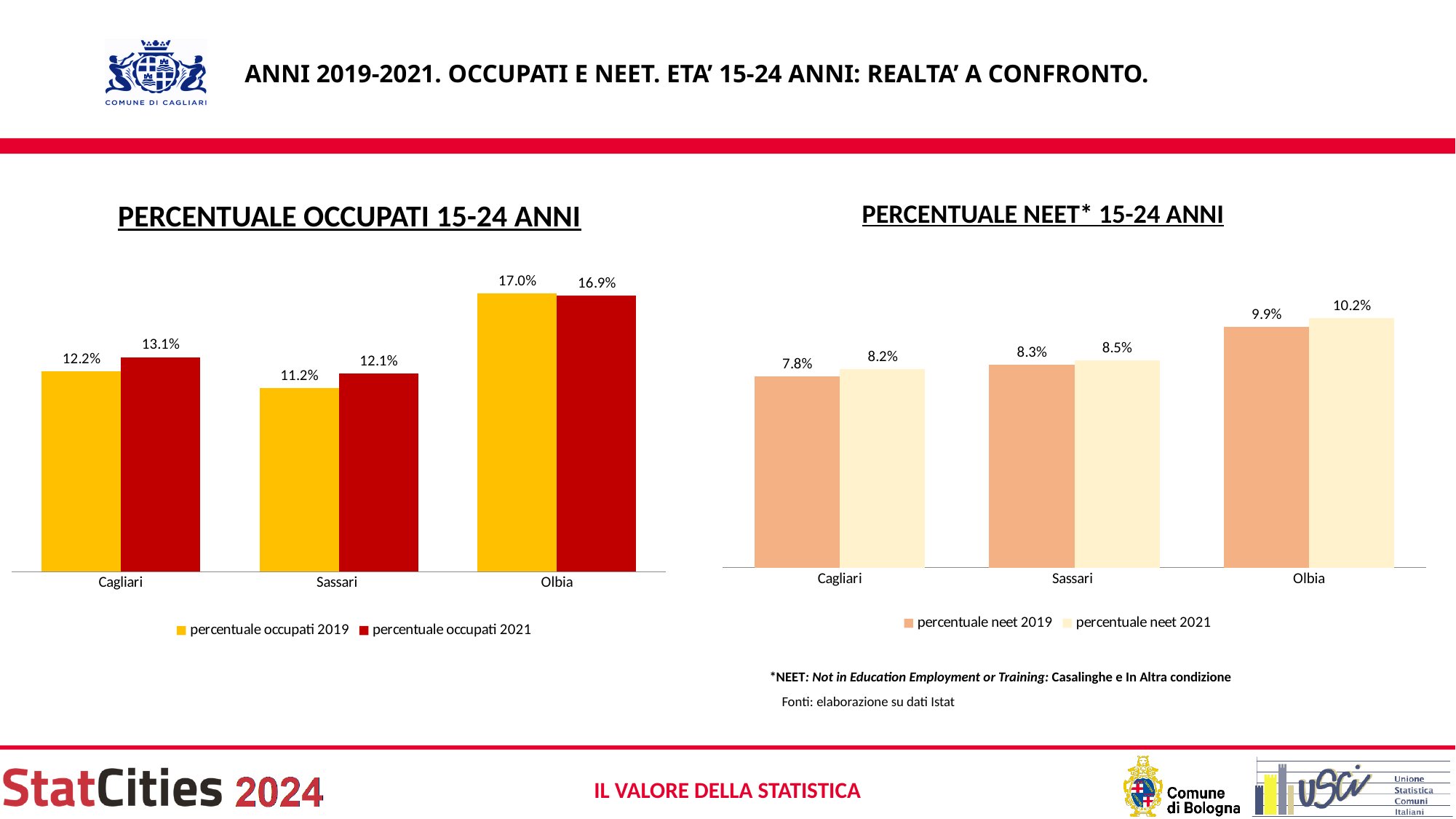
In the 'PERCENTUALE OCCUPATI 15-24 ANNI' chart, how many series does the legend list? 2 In the 'PERCENTUALE NEET* 15-24 ANNI' chart, which city has the lowest value for 'percentuale neet 2019'? Cagliari In the 'PERCENTUALE NEET* 15-24 ANNI' chart, what is the difference between the 2021 and 2019 values for Sassari? 0.2% In the 'PERCENTUALE OCCUPATI 15-24 ANNI' chart, what is the value for Cagliari in the 'percentuale occupati 2019' series? 12.2% In the 'PERCENTUALE OCCUPATI 15-24 ANNI' chart, what is the value for Sassari in the 'percentuale occupati 2021' series? 12.1% In the 'PERCENTUALE OCCUPATI 15-24 ANNI' chart, what is the difference between the 2021 and 2019 values for Cagliari? 0.9% In the 'PERCENTUALE OCCUPATI 15-24 ANNI' chart, which city has the lowest value for 'percentuale occupati 2021'? Sassari In the 'PERCENTUALE NEET* 15-24 ANNI' chart, what is the value for Olbia in the 'percentuale neet 2021' series? 10.2% In the 'PERCENTUALE NEET* 15-24 ANNI' chart, what is the value for Cagliari in the 'percentuale neet 2019' series? 7.8% In the 'PERCENTUALE OCCUPATI 15-24 ANNI' chart, which city has the highest value for 'percentuale occupati 2019'? Olbia In the 'PERCENTUALE NEET* 15-24 ANNI' chart, how many cities are shown on the x axis? 3 What kind of chart is the 'PERCENTUALE NEET* 15-24 ANNI' chart? Bar chart